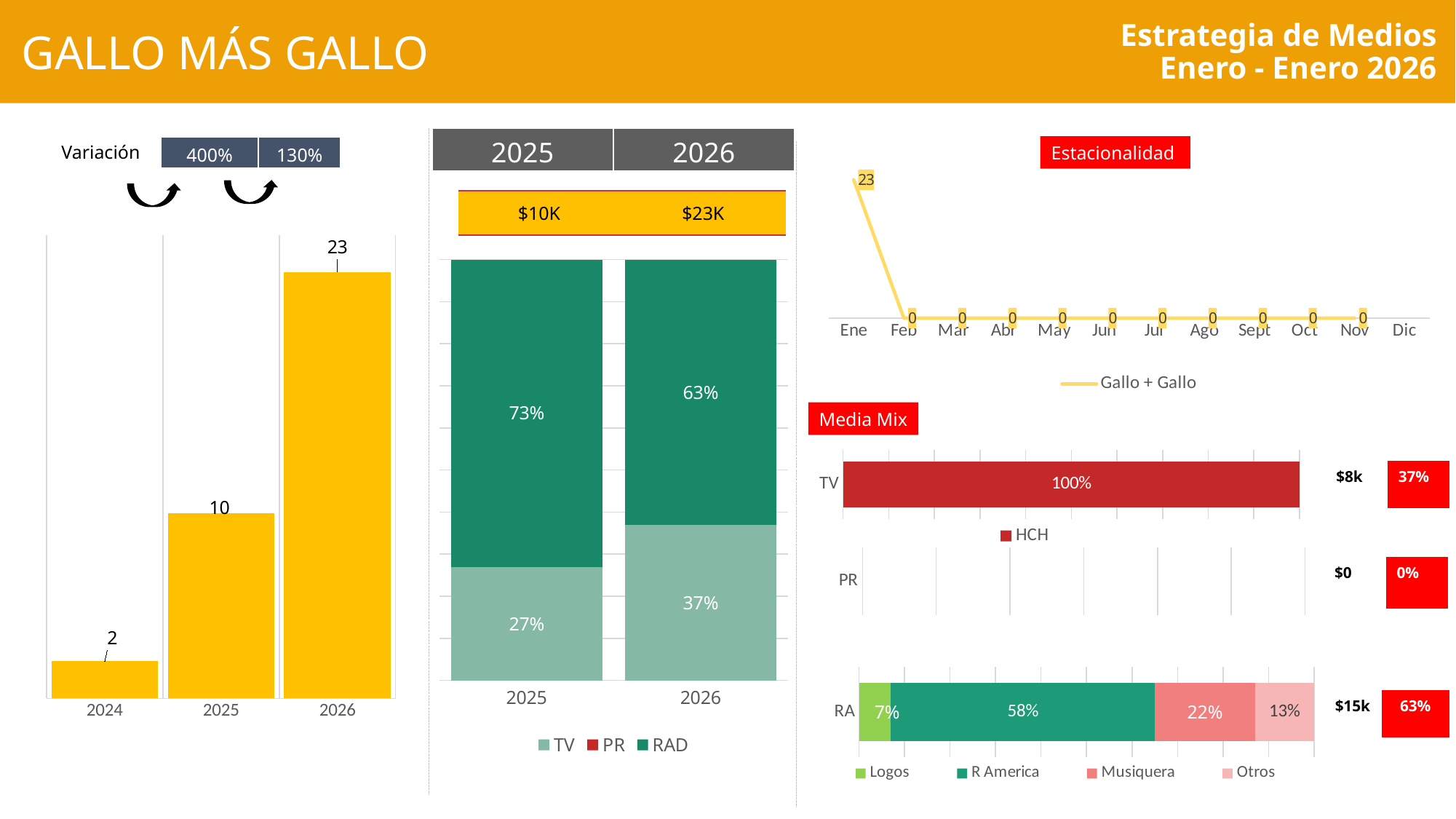
In the stacked bar chart in the middle, what share does RAD have in 2025? 73% In the yellow bar chart on the left, what is the value for 2024? 2 In the yellow bar chart on the left, what is the value for 2026? 23 In the stacked bar chart in the middle, how many series does the legend list? 3 In the stacked bar chart in the middle, what share does TV have in 2026? 37% In the yellow bar chart on the left, which year has the highest value? 2026 In the Media Mix RA bar, which segment is the smallest? Logos In the Estacionalidad line chart, what is the value for Ene? 23 In the yellow bar chart on the left, do the values rise or fall from 2024 to 2026? rise In the Estacionalidad line chart, what is the name of the series in the legend? Gallo + Gallo In the Media Mix RA bar, what share does R America have? 58% In the yellow bar chart on the left, what is the difference between the 2026 and 2025 values? 13